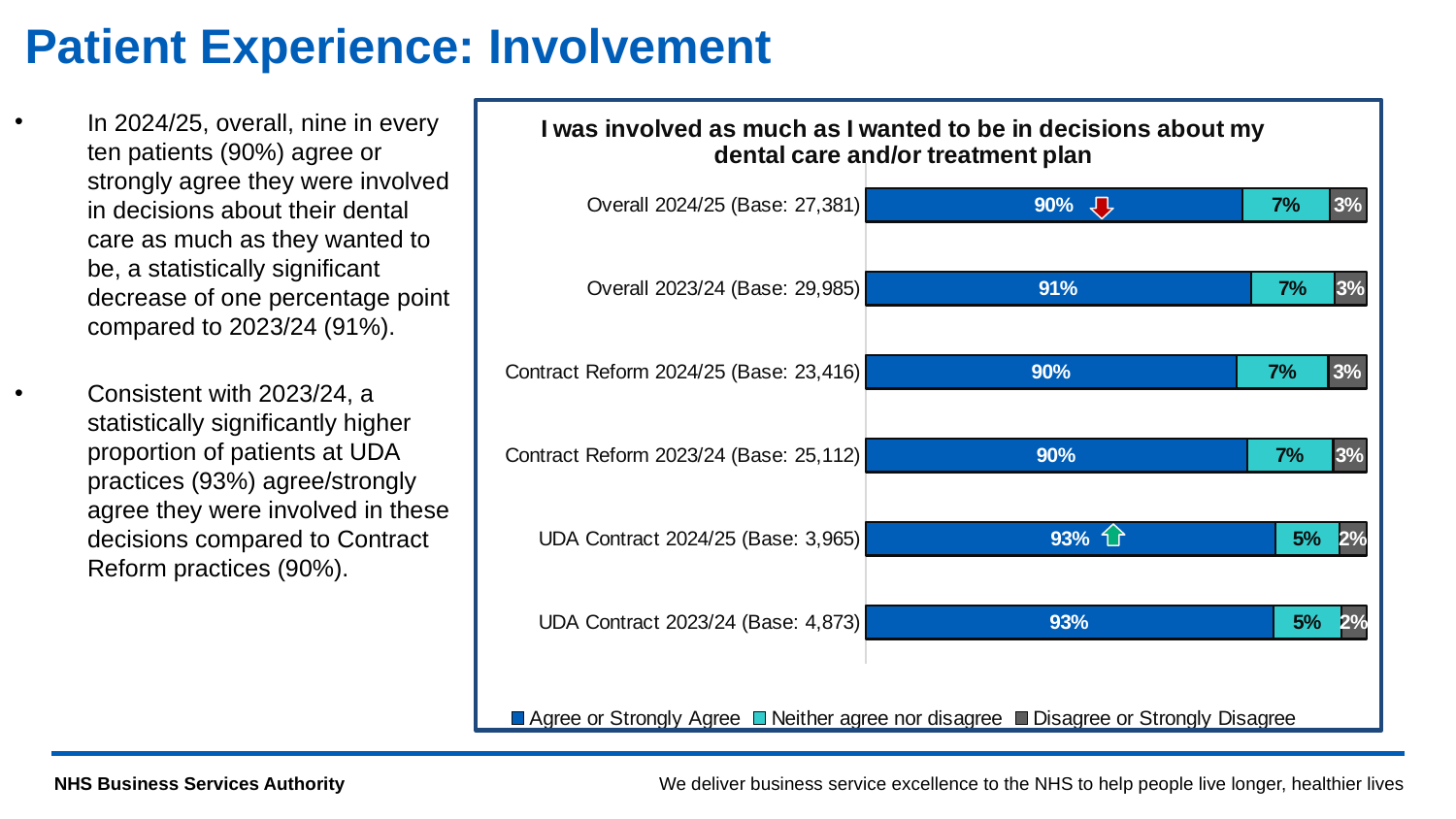
Which category has the highest Agree or Strongly Agree percentage? UDA Contract 2024/25 and UDA Contract 2023/24 (93%) Which is larger: the Agree or Strongly Agree value for Overall 2023/24 or for Overall 2024/25? Overall 2023/24 What percentage of Contract Reform 2023/24 respondents disagree or strongly disagree? 3% How many categories (bars) are shown in the chart? 6 What is the Agree or Strongly Agree value for Overall 2023/24? 91% Which category has the lowest Disagree or Strongly Disagree percentage? UDA Contract 2024/25 and UDA Contract 2023/24 (2%) What is the base (number of respondents) for Contract Reform 2024/25? 23,416 What is the difference in Agree or Strongly Agree percentage between UDA Contract 2024/25 and Contract Reform 2024/25? 3 percentage points What percentage of UDA Contract 2023/24 respondents neither agree nor disagree? 5% How many series does the legend list? 3 What type of chart is shown on the slide? Stacked bar chart What percentage of Overall 2024/25 respondents agree or strongly agree they were involved in decisions about their dental care? 90%